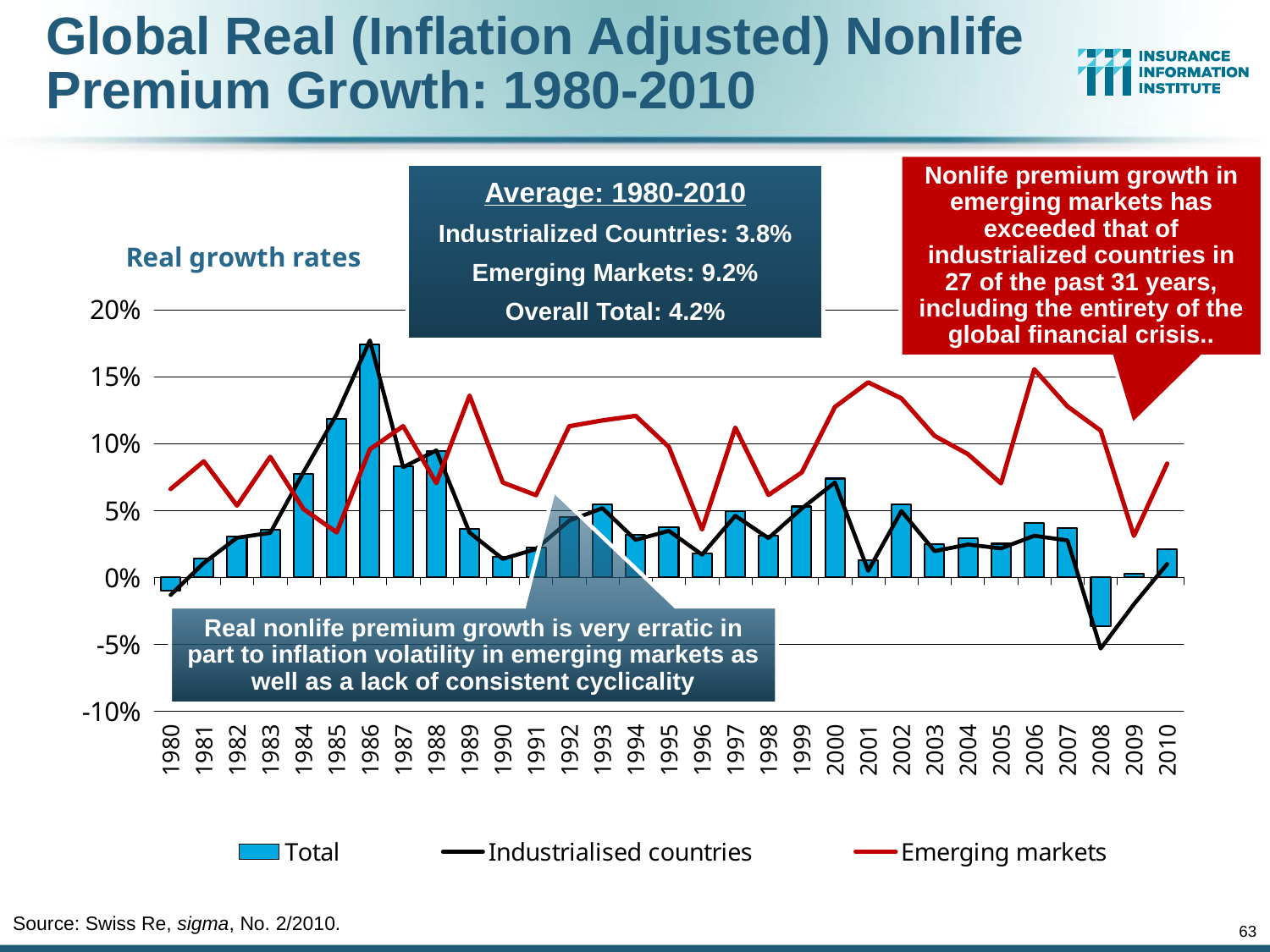
Which series is drawn as a red line? Emerging markets Is the Industrialised countries value for 2008 greater or less than 0%? less How many years are shown on the x axis? 31 Is the Total value for 1986 greater or less than 15%? greater Is the Total value for 2008 greater or less than 0%? less In which year is the Total bar highest? 1986 How many series does the legend list? 3 In which year is the Total bar lowest? 2008 In 1986, which is higher: Industrialised countries or Emerging markets? Industrialised countries According to the text box, what is the 1980-2010 average growth for Emerging Markets? 9.2% What kind of chart is this? Combined bar and line chart